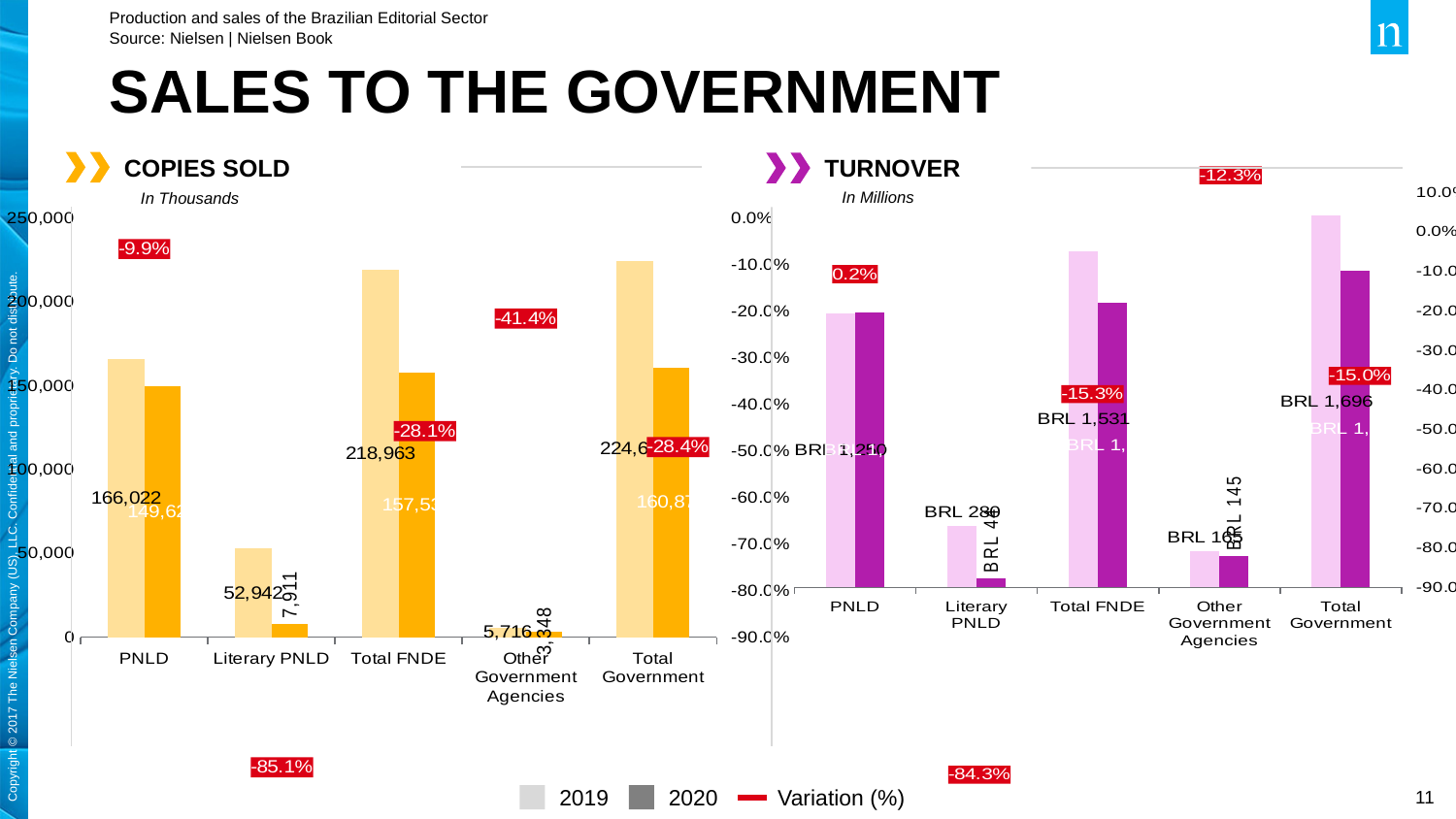
In the COPIES SOLD chart, what is the 2019 value for PNLD? 166,022 In the COPIES SOLD chart, is the 2020 value for Total Government greater or less than 150,000? greater In the COPIES SOLD chart, what is the 2020 value for Literary PNLD? 7,911 In the COPIES SOLD chart, what is the difference between the 2019 and 2020 values for Other Government Agencies? 2,368 In the TURNOVER chart, what is the 2020 value for Other Government Agencies? BRL 145 How many entries does the legend at the bottom of the slide list? 3 How many categories are shown on the x axis of the TURNOVER chart? 5 In the TURNOVER chart, what variation (%) is shown for Total Government? -15.0% In the TURNOVER chart, what is the 2019 value for Total FNDE? BRL 1,531 In the COPIES SOLD chart, which is larger, the 2019 value for PNLD or the 2019 value for Literary PNLD? PNLD In the COPIES SOLD chart, what variation (%) is shown for Literary PNLD? -85.1% In the COPIES SOLD chart, which category has the lowest 2019 value? Other Government Agencies